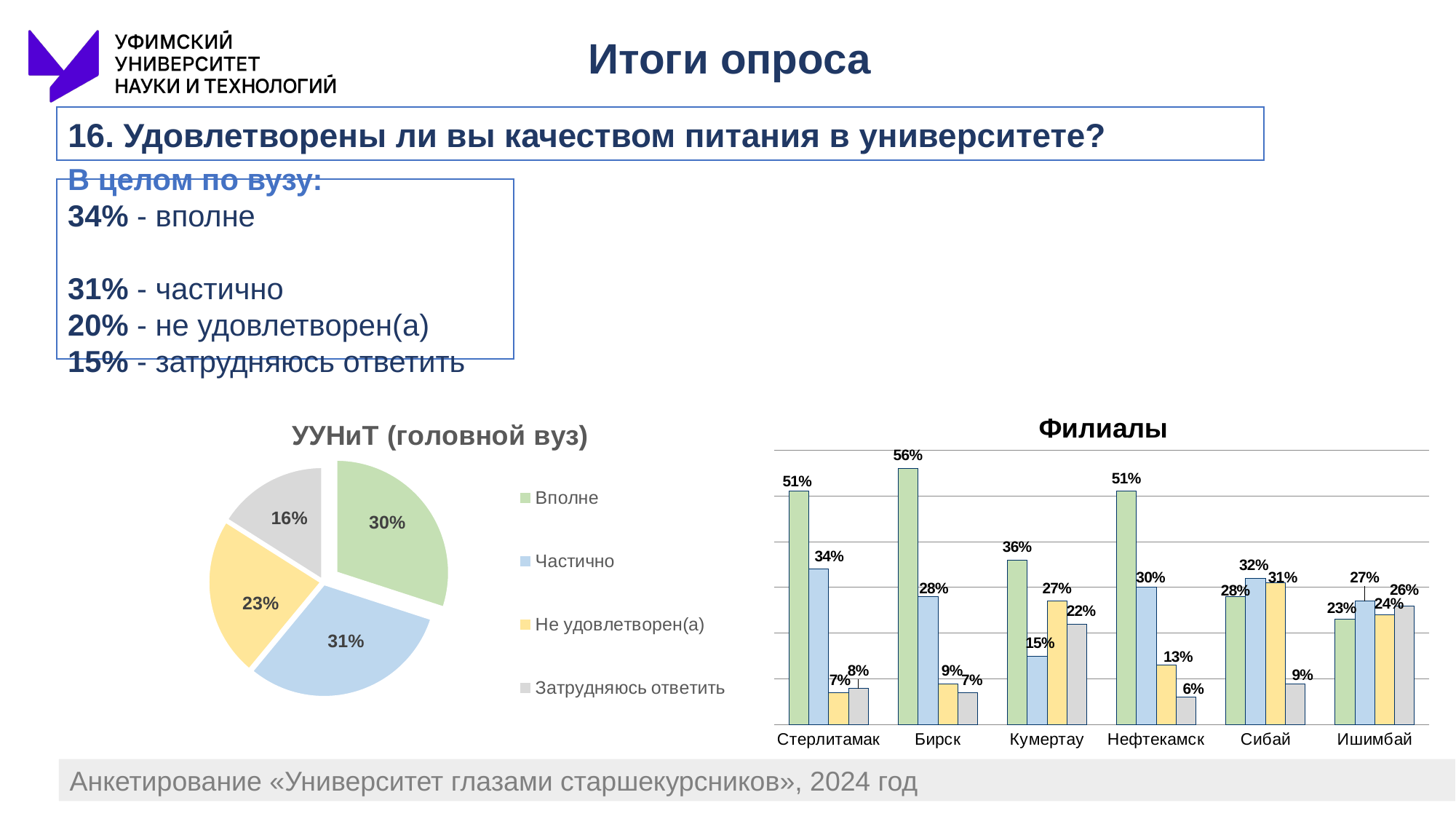
In the 'Филиалы' chart, what is the value of the yellow ('Не удовлетворен(а)') bar for Кумертау? 27% What kind of chart is the 'Филиалы' chart? bar chart In the 'Филиалы' chart, which is larger for Сибай: the blue ('Частично') bar or the green ('Вполне') bar? blue ('Частично'), 32% In the 'УУНиТ (головной вуз)' pie chart, which category has the smallest slice? Затрудняюсь ответить In the 'Филиалы' chart, which branch has the highest green ('Вполне') bar? Бирск How many entries does the legend of the 'УУНиТ (головной вуз)' pie chart list? 4 In the 'Филиалы' chart, what is the difference between the green ('Вполне') bars for Стерлитамак and Ишимбай? 28% What kind of chart is the 'УУНиТ (головной вуз)' chart? pie chart How many branches are shown on the x axis of the 'Филиалы' chart? 6 In the 'УУНиТ (головной вуз)' pie chart, what share does 'Частично' have? 31% In the 'УУНиТ (головной вуз)' pie chart, what share does 'Затрудняюсь ответить' have? 16% In the 'Филиалы' chart, what is the value of the green ('Вполне') bar for Бирск? 56%